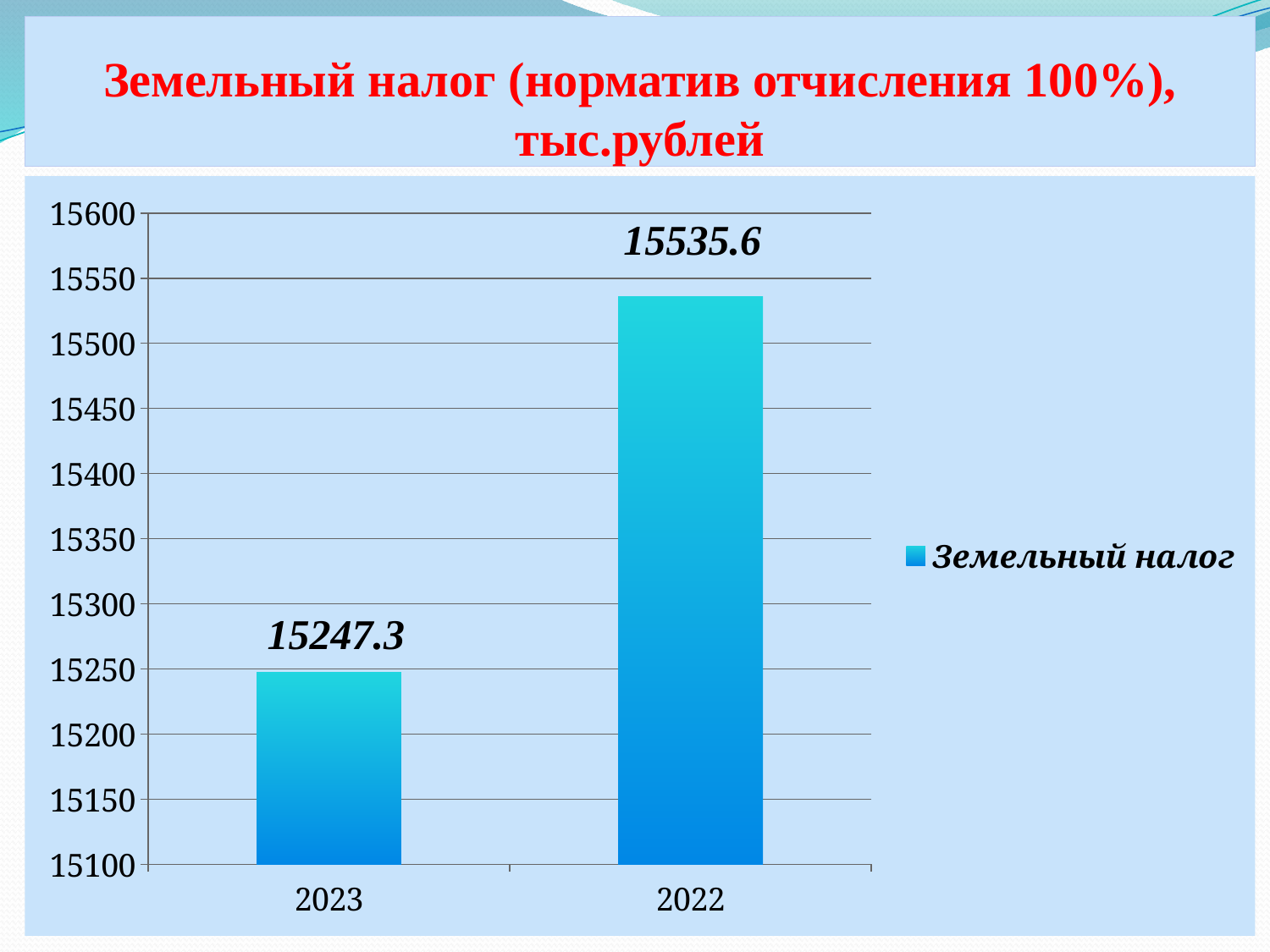
Is the value for 2023 greater or less than 15300? less Which year has the lowest value? 2023 What is the difference between the values for 2022 and 2023? 288.3 What is the legend entry for the series? Земельный налог Which year has the highest value? 2022 Is the value for 2022 greater or less than 15500? greater Which is larger, the value for 2023 or the value for 2022? 2022 What kind of chart is shown on the slide? bar chart What is the value for 2023? 15247.3 How many series does the legend list? 1 What is the value for 2022? 15535.6 How many categories are shown on the x axis? 2